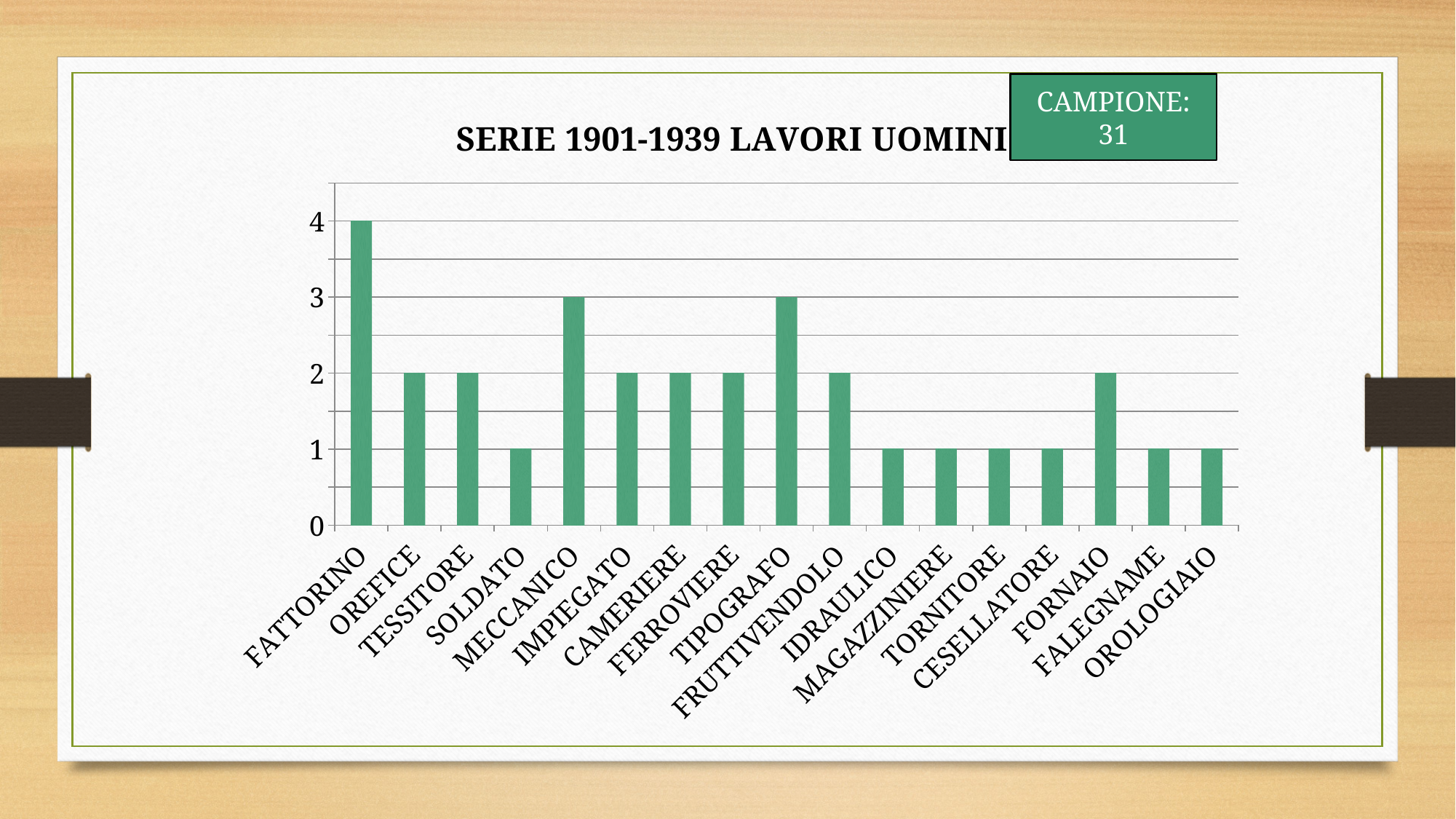
What is the value for MECCANICO? 3 Which category has the highest value? FATTORINO What type of chart is shown on the slide? bar chart What is the title of the chart? SERIE 1901-1939 LAVORI UOMINI Is the value for FATTORINO greater or less than 3? greater What is the value for FATTORINO? 4 What is the value for SOLDATO? 1 What number is shown in the CAMPIONE box on the slide? 31 Which has a larger value, TIPOGRAFO or IDRAULICO? TIPOGRAFO What is the value for FORNAIO? 2 What is the difference between the values for FATTORINO and MECCANICO? 1 How many categories are shown on the x axis? 17